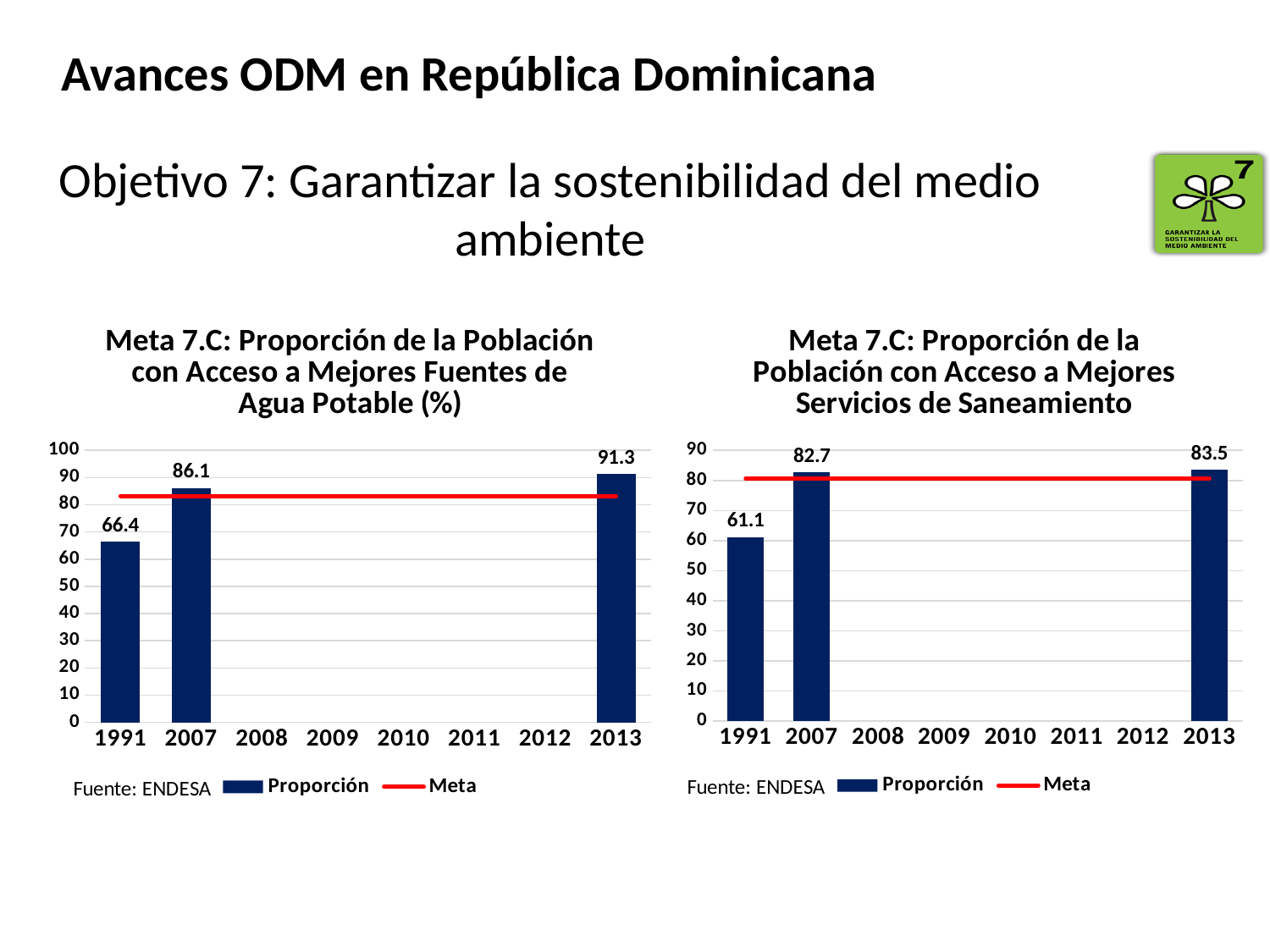
In the right chart (Servicios de Saneamiento), what is the difference between the 2007 and 1991 values? 21.6 In the left chart (Agua Potable), what is the difference between the 2013 and 1991 values? 24.9 In the right chart (Servicios de Saneamiento), which year has the lowest value? 1991 In the left chart (Agua Potable), what is the value for 2013? 91.3 In the left chart (Agua Potable), what is the value for 1991? 66.4 How many series does the legend of the right chart (Servicios de Saneamiento) list? 2 In the right chart (Servicios de Saneamiento), do the Proporción values rise or fall from 1991 to 2013? rise In the left chart (Agua Potable), is the Meta line greater or less than 80? greater In the right chart (Servicios de Saneamiento), what is the value for 1991? 61.1 In the right chart (Servicios de Saneamiento), what is the value for 2007? 82.7 In the left chart (Agua Potable), which year has the highest value? 2013 In the left chart (Agua Potable), which is larger, the value for 2007 or the value for 1991? 2007